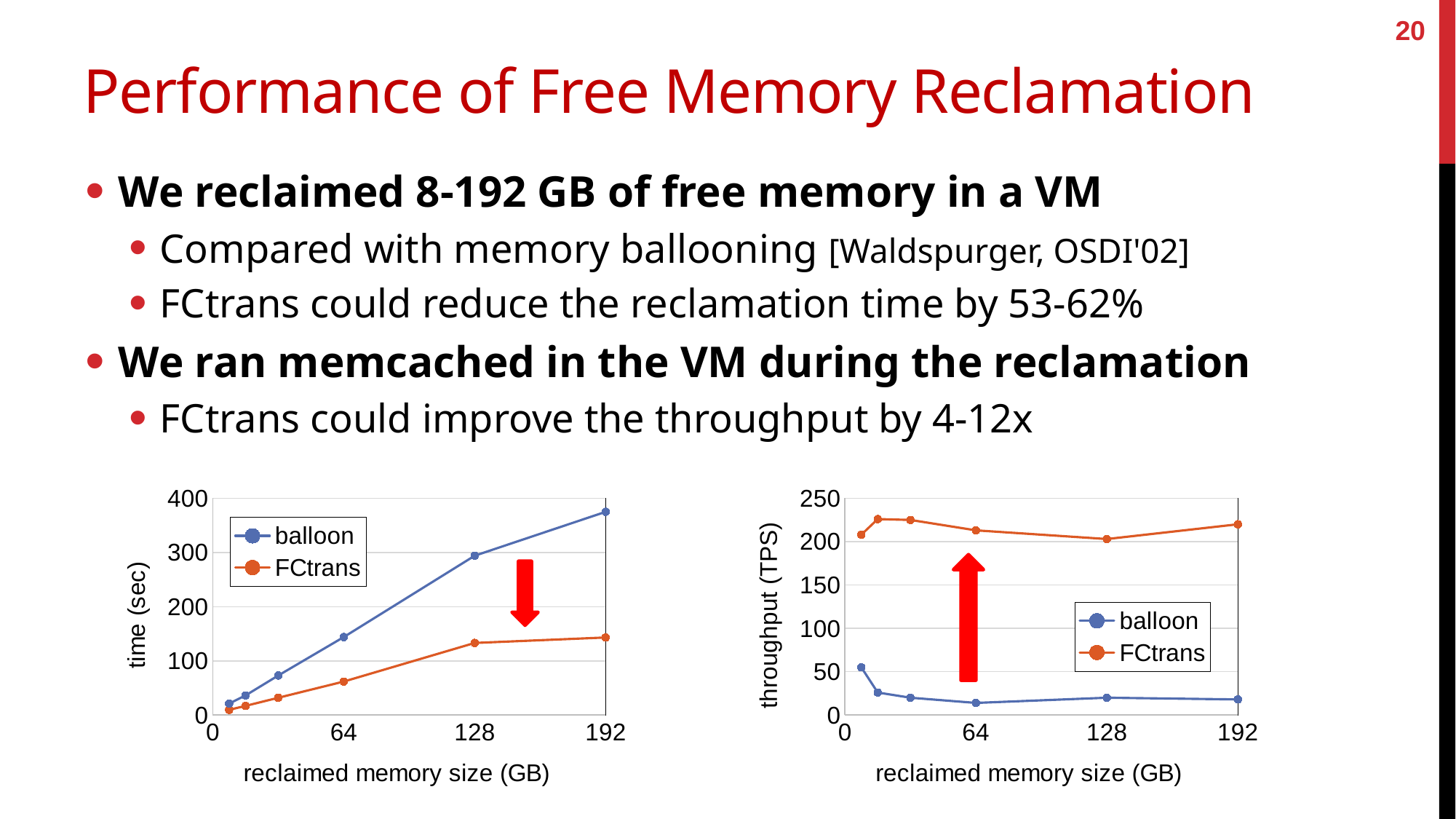
In the left chart (time), does the balloon series rise or fall as reclaimed memory size increases? rise In the right chart (throughput), is the FCtrans value at 64 GB greater or less than 200? greater In the right chart (throughput), does the balloon series rise or fall overall as reclaimed memory size increases? fall In the left chart (time), is the FCtrans value at 192 GB greater or less than 200? less How many data points does the balloon series have in the left chart (time)? 6 In the left chart (time), is the balloon value at 192 GB greater or less than 300? greater What kind of chart is the left chart (time vs reclaimed memory size)? line chart How many series does the legend of the right chart (throughput) list? 2 What is the y-axis label of the right chart? throughput (TPS) In the left chart (time), which series has the higher time at 192 GB, balloon or FCtrans? balloon In the right chart (throughput), which series has the higher throughput at 128 GB, balloon or FCtrans? FCtrans